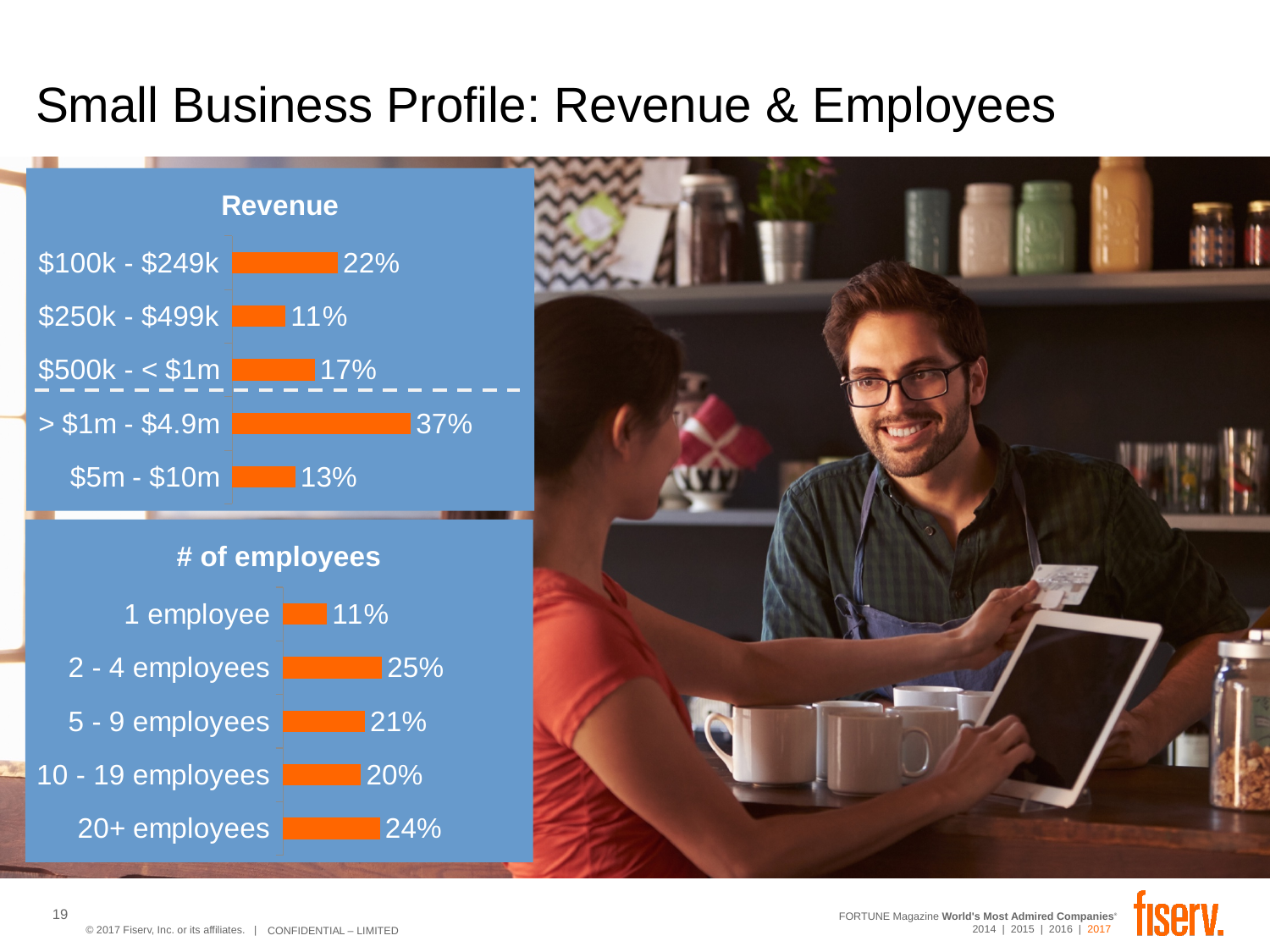
In the Revenue chart, how many revenue categories are shown? 5 In the # of employees chart, which category has the highest percentage? 2 - 4 employees In the # of employees chart, what percentage of small businesses have 2 - 4 employees? 25% In the Revenue chart, what is the difference between the $100k - $249k and $5m - $10m values? 9% In the Revenue chart, which revenue category has the lowest percentage? $250k - $499k In the # of employees chart, what is the difference between the 2 - 4 employees and 1 employee values? 14% In the Revenue chart, what is the value for the $250k - $499k category? 11% In the Revenue chart, which revenue category has the highest percentage? > $1m - $4.9m In the Revenue chart, what percentage of small businesses have revenue of > $1m - $4.9m? 37% In the # of employees chart, which is larger: the value for 5 - 9 employees or 20+ employees? 20+ employees In the # of employees chart, which category has the lowest percentage? 1 employee What type of chart is the Revenue chart? Bar chart